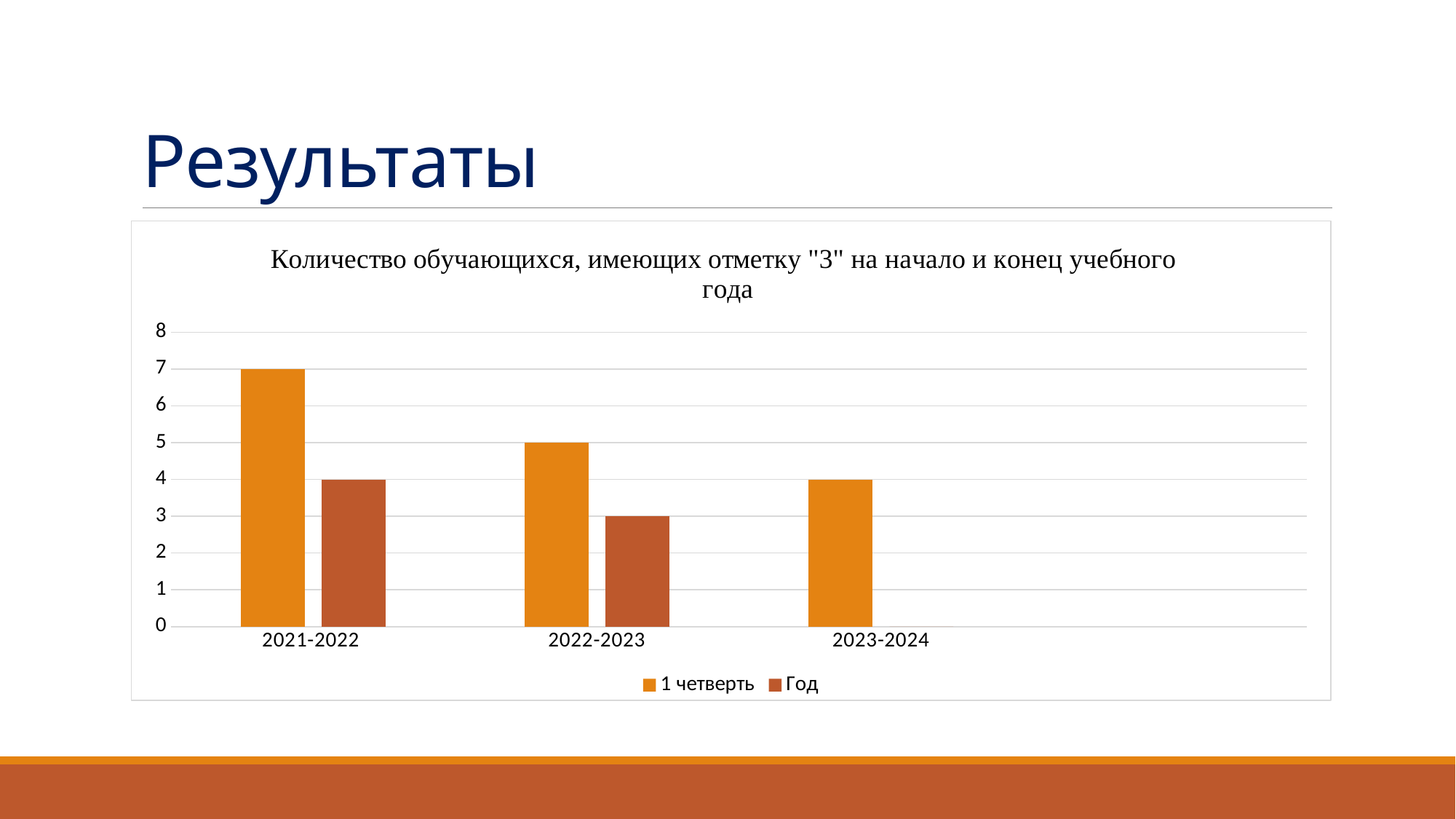
What is the value for "1 четверть" in 2023-2024? 4 How many academic years are shown on the x axis? 3 Do the "1 четверть" values rise or fall from 2021-2022 to 2023-2024? fall Which academic year has the highest value for "1 четверть"? 2021-2022 What is the value for "Год" in 2022-2023? 3 What is the difference between the "1 четверть" and "Год" values in 2021-2022? 3 What is the value for "Год" in 2021-2022? 4 What kind of chart is shown on the slide? bar chart What is the value for "1 четверть" in 2021-2022? 7 Which is larger in 2022-2023: "1 четверть" or "Год"? 1 четверть How many series does the legend list? 2 What is the value for "1 четверть" in 2022-2023? 5